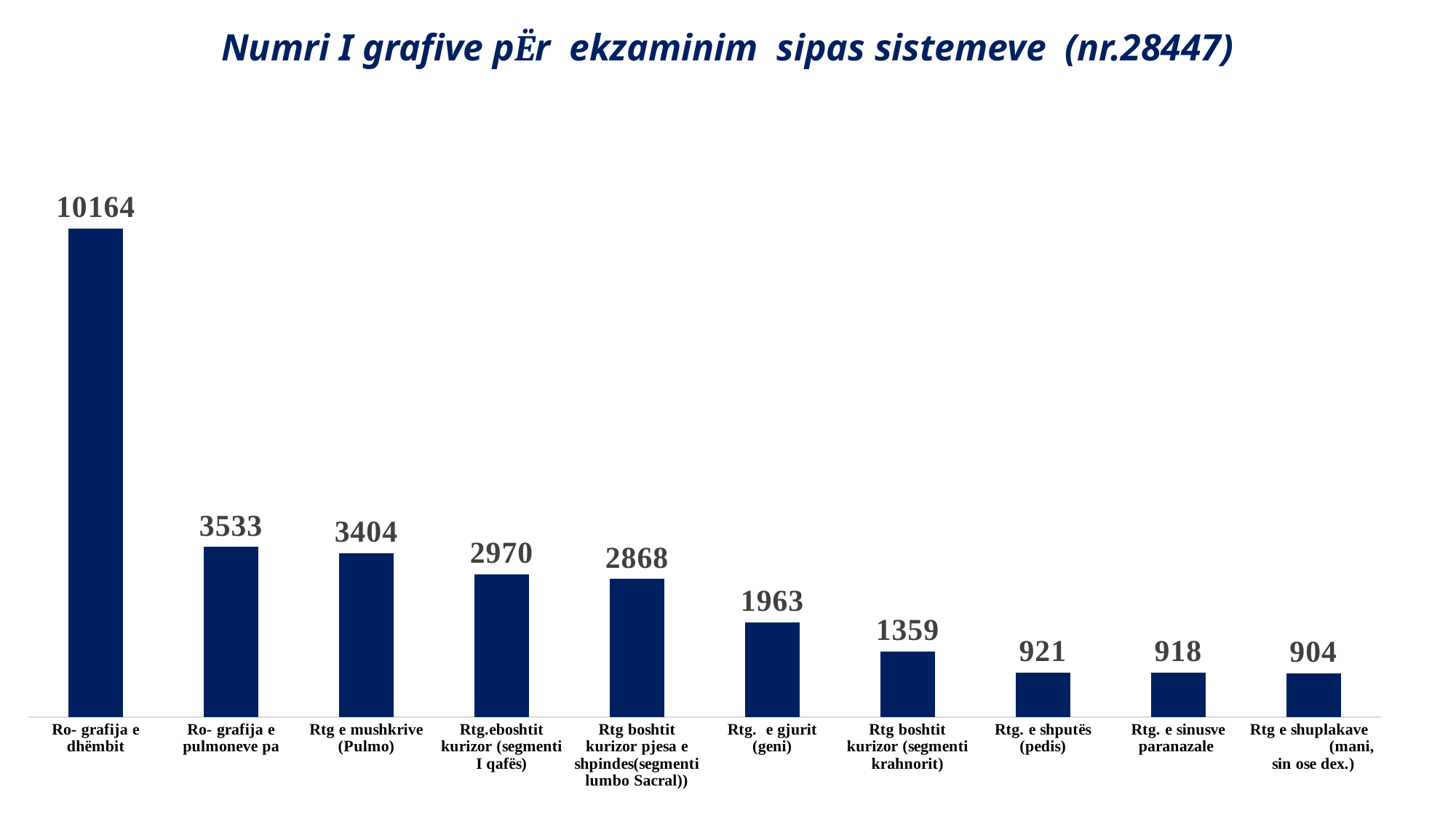
How many categories are shown in the chart? 10 What is the value for Rtg. e sinusve paranazale? 918 What is the value for Rtg e mushkrive (Pulmo)? 3404 Do the values rise or fall from left to right along the x axis? fall What is the value for Ro- grafija e dhëmbit? 10164 What is the value for Rtg. e gjurit (geni)? 1963 Which is larger, the value for Rtg.eboshtit kurizor (segmenti I qafës) or the value for Rtg boshtit kurizor pjesa e shpindes(segmenti lumbo Sacral))? Rtg.eboshtit kurizor (segmenti I qafës) What is the difference between the values for Rtg. e gjurit (geni) and Rtg boshtit kurizor (segmenti krahnorit)? 604 Which category has the lowest value? Rtg e shuplakave (mani, sin ose dex.) What kind of chart is shown on the slide? bar chart Which category has the highest value? Ro- grafija e dhëmbit What is the difference between the values for Ro- grafija e pulmoneve pa and Rtg e mushkrive (Pulmo)? 129